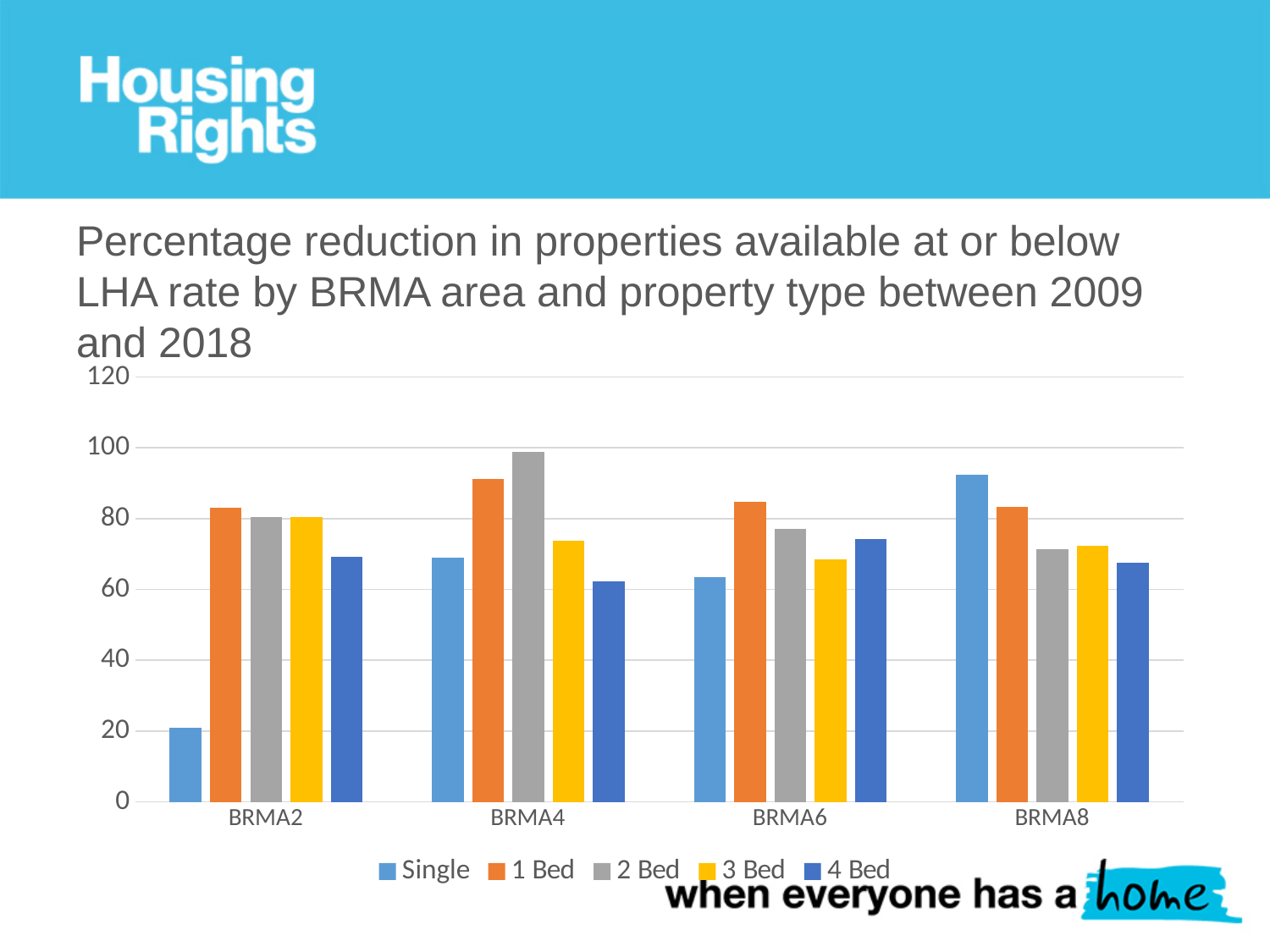
For the Single series, which BRMA area has the highest value? BRMA8 What kind of chart is shown on the slide? bar chart How many BRMA areas are shown on the x axis of the chart? 4 In BRMA4, which is larger: the value for 1 Bed or the value for 4 Bed? 1 Bed Within BRMA2, which property type has the lowest percentage reduction? Single In BRMA8, which is larger: the value for Single or the value for 1 Bed? Single Which series is listed first in the chart's legend? Single How many series does the chart's legend list? 5 Is the value for Single in BRMA2 greater or less than 40? less Is the value for 4 Bed in BRMA6 greater or less than 60? greater Is the value for 2 Bed in BRMA4 greater or less than 80? greater Within BRMA4, which property type has the highest percentage reduction? 2 Bed